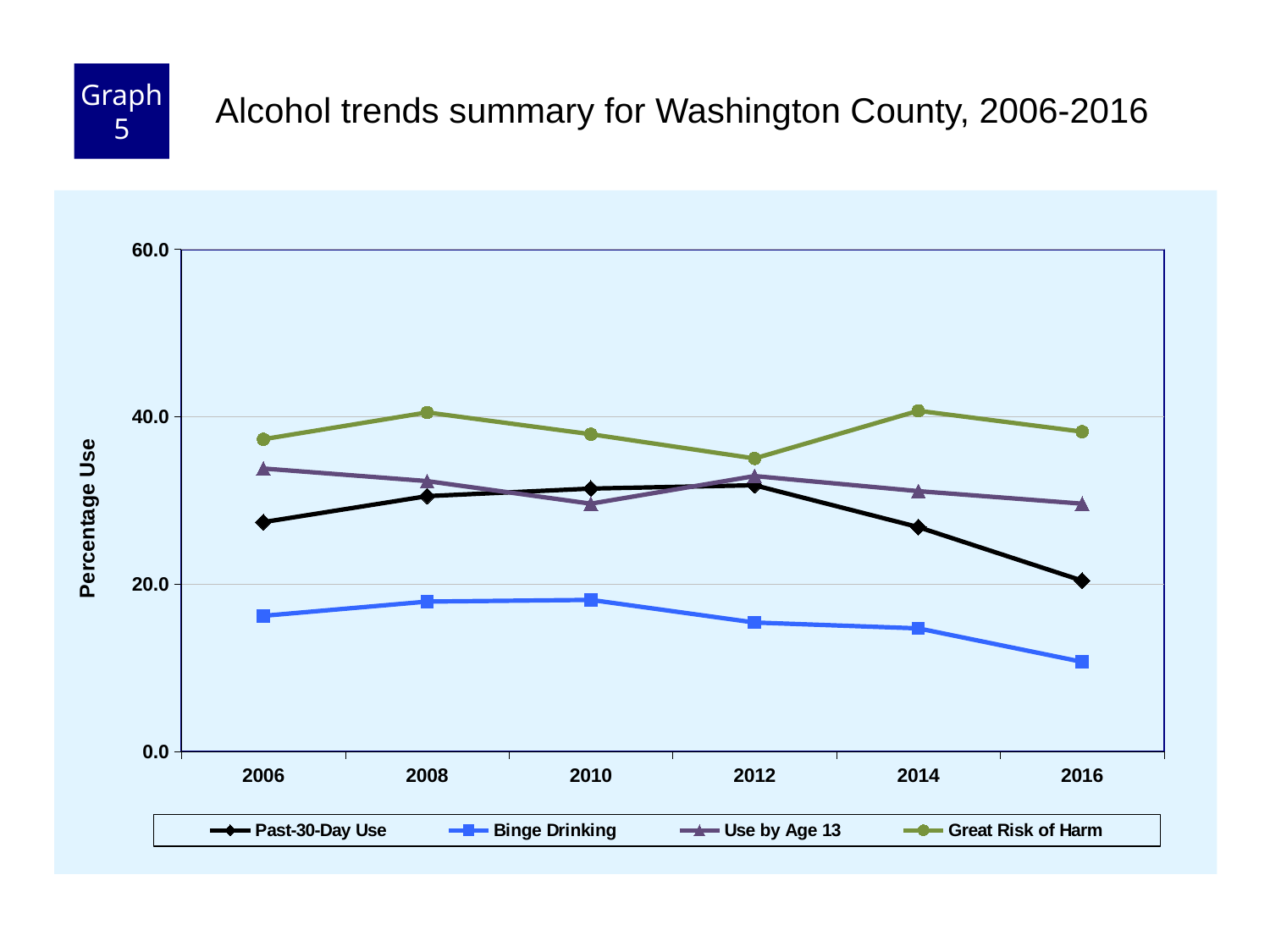
Which series is plotted with the lowest values across all years? Binge Drinking How many years are plotted along the x axis? 6 In 2006, which is larger: Great Risk of Harm or Use by Age 13? Great Risk of Harm In which year is Past-30-Day Use at its lowest? 2016 How many series does the legend list? 4 Does Past-30-Day Use rise or fall from 2012 to 2016? fall Which series is plotted with the highest values across all years? Great Risk of Harm In which year is Binge Drinking at its lowest? 2016 Is the value for Binge Drinking in 2016 greater or less than 20.0? less What kind of chart is shown on the slide? line chart Is the value for Great Risk of Harm in 2012 greater or less than 40.0? less What is the title of the y axis? Percentage Use